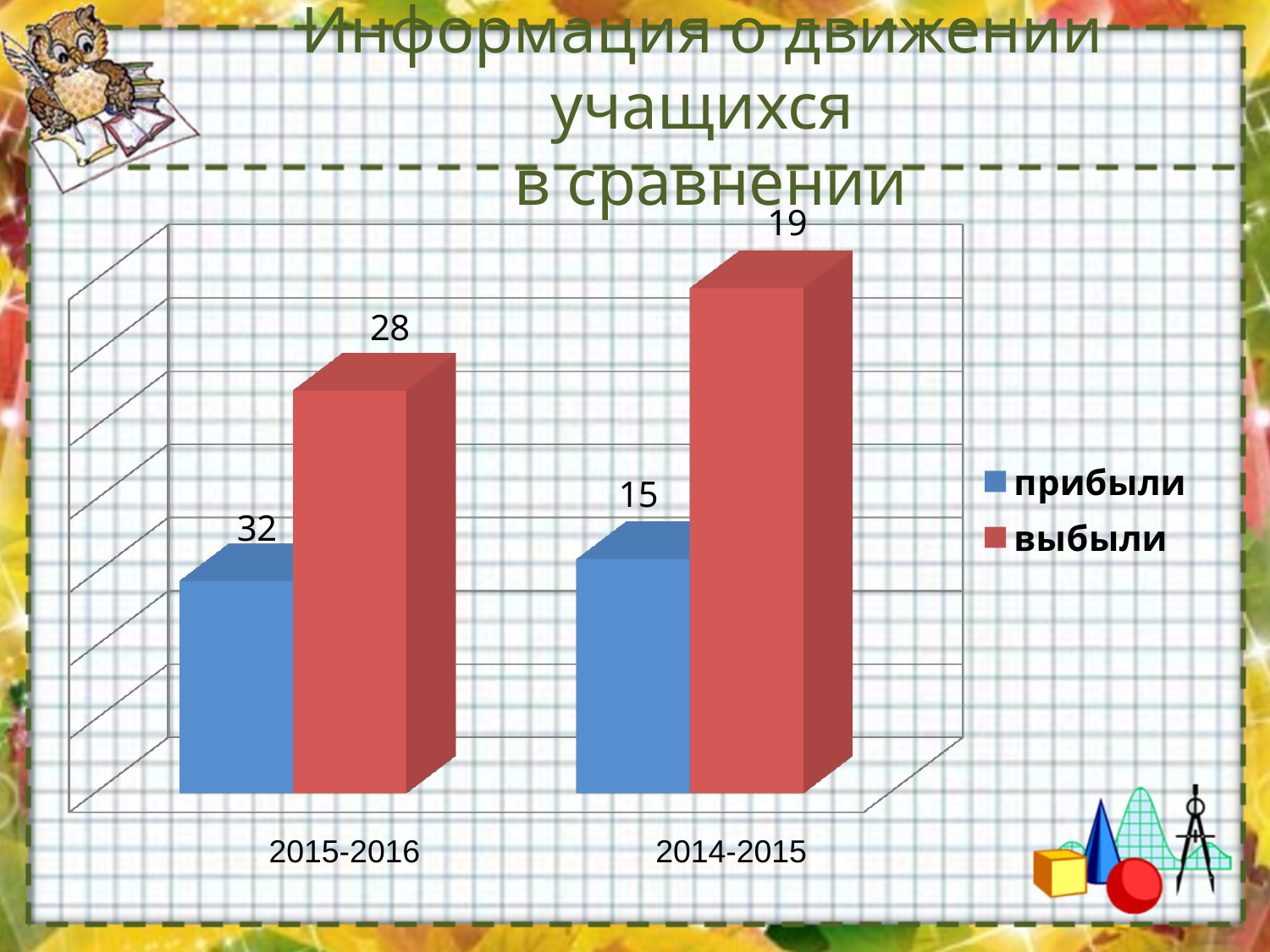
What is the difference between the прибыли values for 2015-2016 and 2014-2015? 17 What is the difference between the прибыли and выбыли values in 2015-2016? 4 What is the value for выбыли in 2014-2015? 19 How many categories are shown on the x axis? 2 Which series is shown in red according to the legend? выбыли How many series does the legend list? 2 What is the value for прибыли in 2015-2016? 32 What is the value for прибыли in 2014-2015? 15 What is the difference between the выбыли and прибыли values in 2014-2015? 4 What is the value for выбыли in 2015-2016? 28 What kind of chart is shown on the slide? bar chart